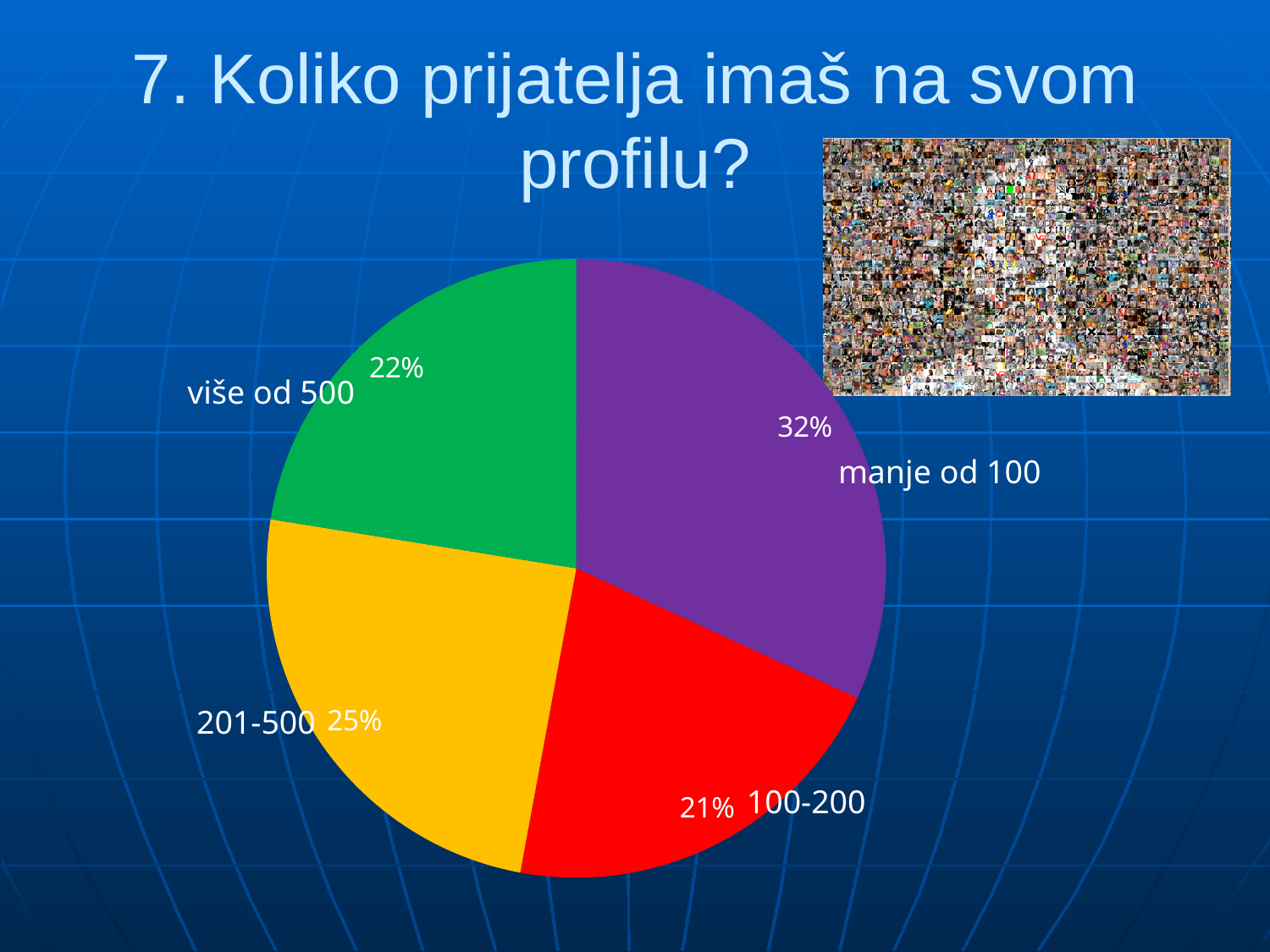
What is the difference between the shares of "201-500" and "više od 500"? 3% What share of the pie does "201-500" have? 25% What share of the pie does "manje od 100" have? 32% What share of the pie does "100-200" have? 21% What colour is the slice for "manje od 100"? purple Which category has the largest slice of the pie? manje od 100 How many slices does the pie chart have? 4 What is the difference between the shares of "manje od 100" and "100-200"? 11% Which is larger, the share for "201-500" or the share for "više od 500"? 201-500 Which category has the smallest slice of the pie? 100-200 What kind of chart is shown on the slide? pie chart